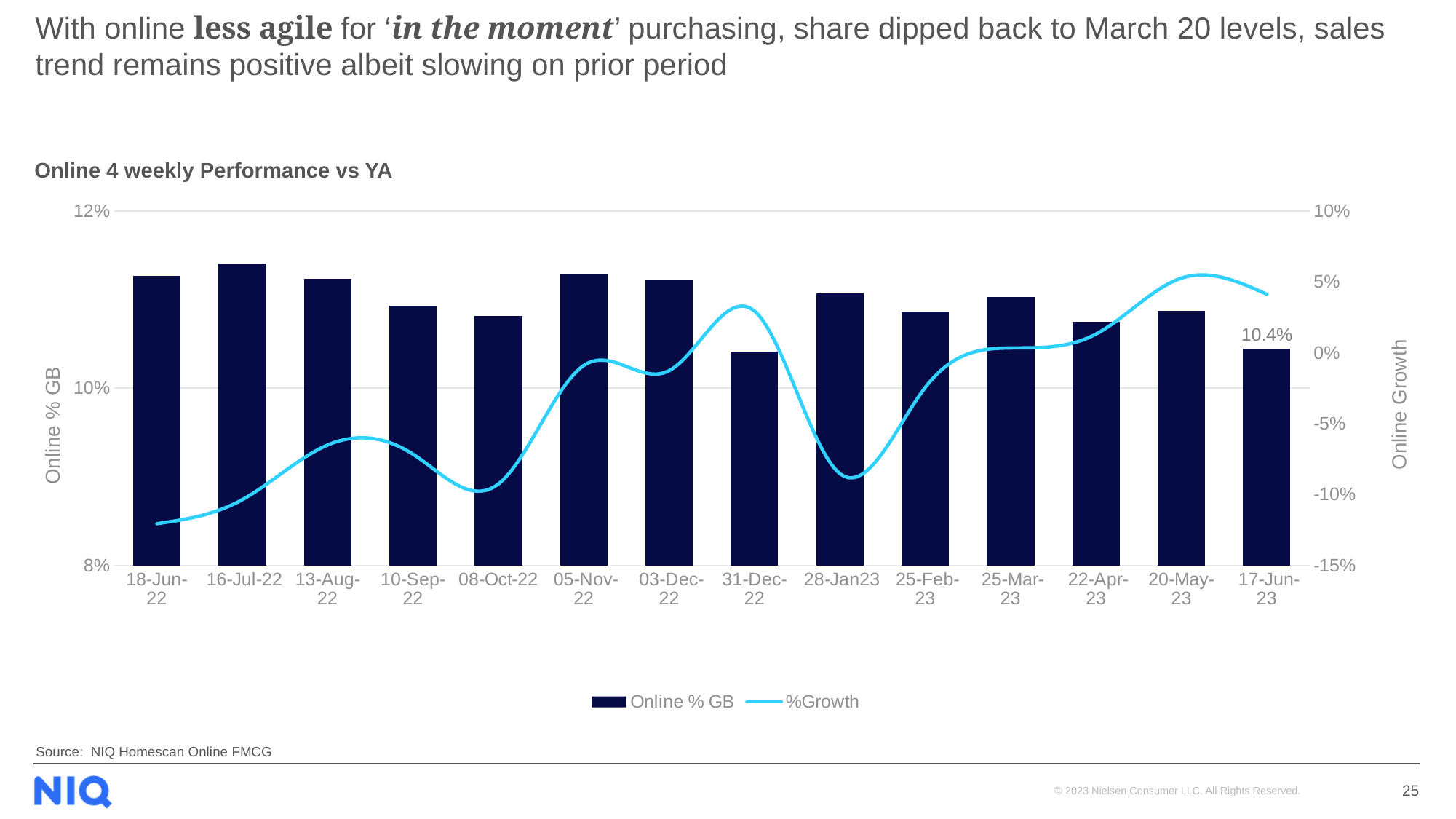
Which period has the highest Online % GB bar? 16-Jul-22 How many series does the legend list? 2 Which has the larger Online % GB bar, 16-Jul-22 or 10-Sep-22? 16-Jul-22 What is the Online % GB value shown for 17-Jun-23? 10.4% Is the %Growth value for 28-Jan23 greater or less than -5%? less Is the Online % GB value for 18-Jun-22 greater or less than 10%? greater Does the %Growth line rise or fall between 28-Jan23 and 20-May-23? rise What is the label on the right-hand vertical axis? Online Growth What is the title of the chart? Online 4 weekly Performance vs YA Is the %Growth value for 18-Jun-22 greater or less than -10%? less What kind of chart is this? Combined bar and line chart How many periods are shown on the x axis? 14